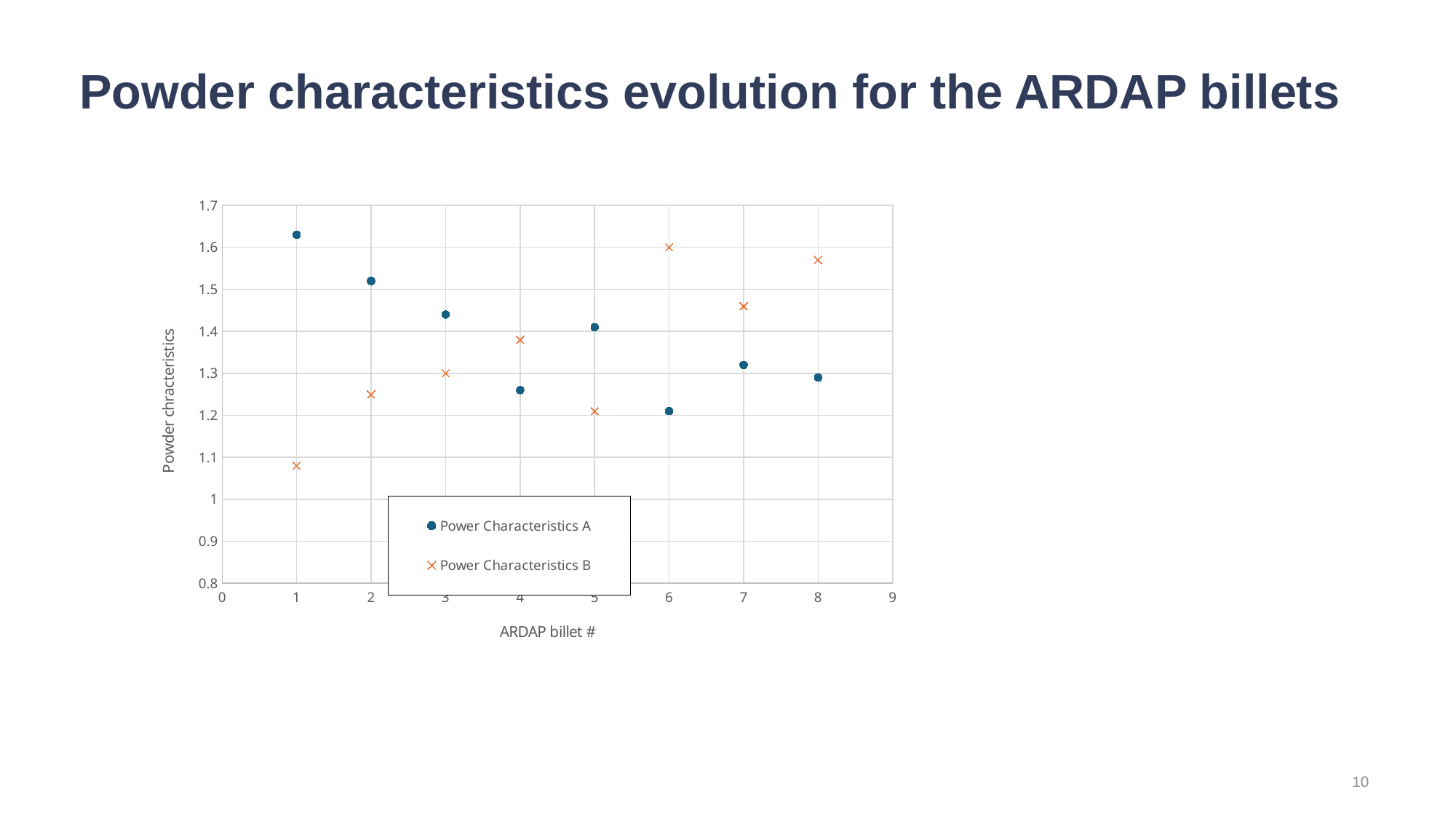
How many ARDAP billets are plotted for Power Characteristics A? 8 Is the value of Power Characteristics B for ARDAP billet 1 greater or less than 1.2? less For ARDAP billet 6, which series has the larger value, Power Characteristics A or Power Characteristics B? Power Characteristics B Is the value of Power Characteristics A for ARDAP billet 6 greater or less than 1.3? less What is the title of the x axis? ARDAP billet # Is the value of Power Characteristics A for ARDAP billet 1 greater or less than 1.5? greater At which ARDAP billet number is Power Characteristics A lowest? 6 At which ARDAP billet number is Power Characteristics B lowest? 1 What kind of chart is shown on the slide? scatter chart At which ARDAP billet number is Power Characteristics A highest? 1 How many series does the legend list? 2